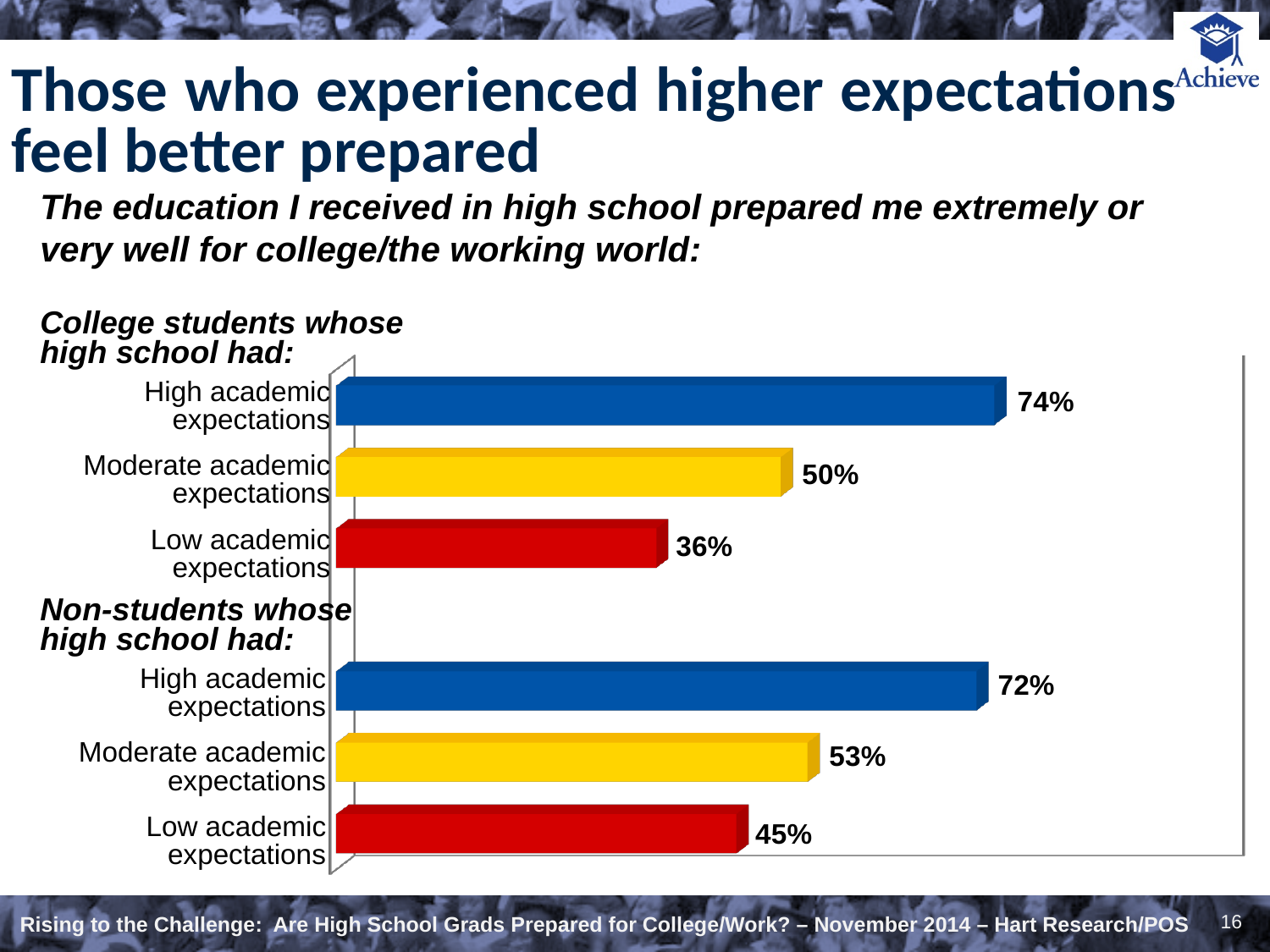
Which is larger: the low academic expectations value for non-students or for college students? Non-students What percentage of college students whose high school had high academic expectations say their education prepared them extremely or very well? 74% Which group has the highest value on the chart? College students whose high school had high academic expectations What kind of chart is shown on the slide? Bar chart What is the value for non-students whose high school had high academic expectations? 72% What is the difference between the moderate academic expectations values for non-students and college students? 3 percentage points How many bars are plotted on the chart? 6 What colour are the bars for the low academic expectations groups? Red What is the difference between the high academic expectations and low academic expectations values for college students? 38 percentage points What is the value for non-students whose high school had low academic expectations? 45% Which group has the lowest value on the chart? College students whose high school had low academic expectations What is the value for college students whose high school had moderate academic expectations? 50%